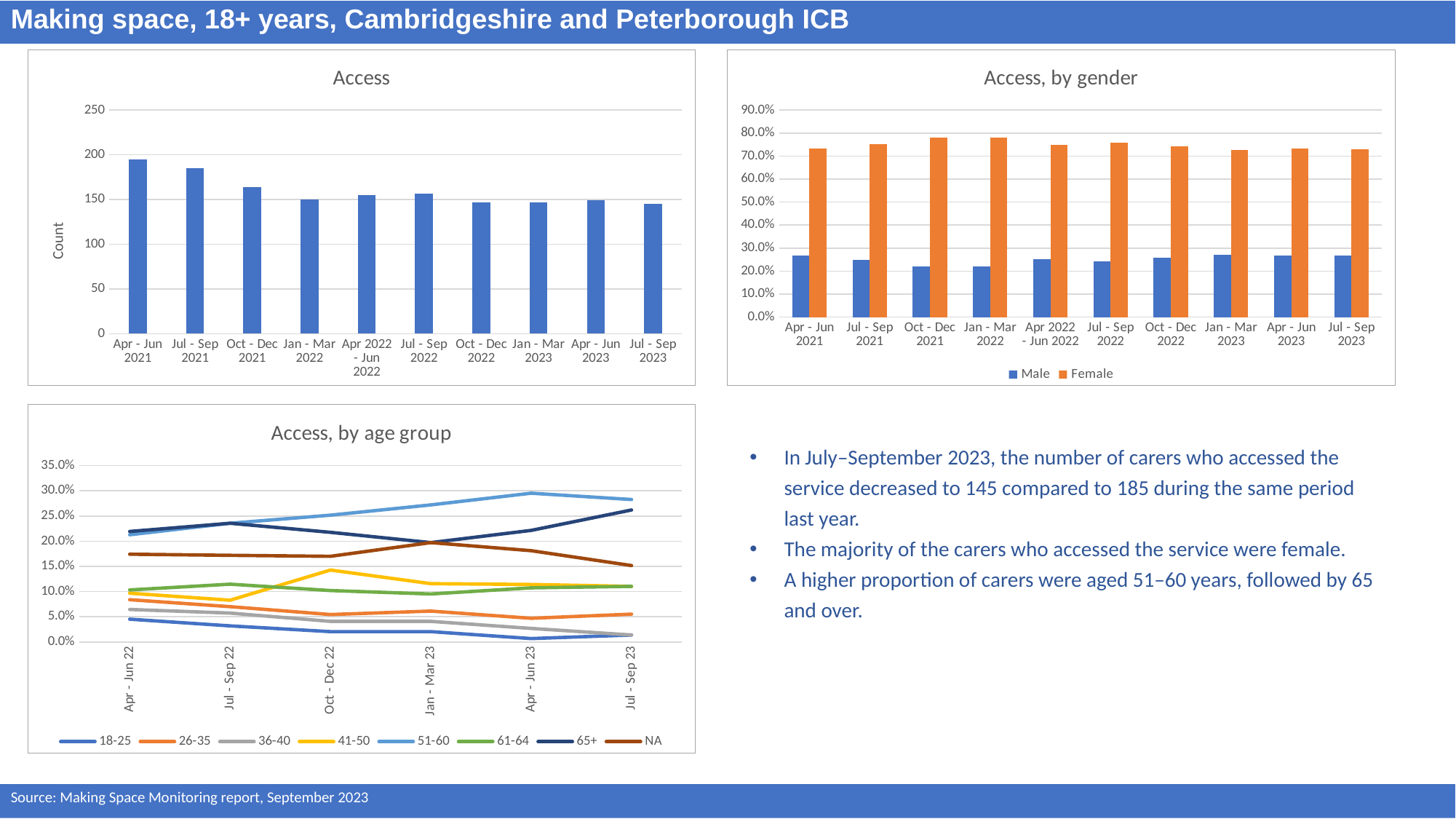
In the "Access" chart, is the count for Jan - Mar 2022 greater or less than 200? less What kind of chart is the "Access" chart? bar chart What kind of chart is the "Access, by age group" chart? line chart How many time periods are shown on the x axis of the "Access" chart? 10 In the "Access" chart, which is larger: the count for Apr - Jun 2021 or the count for Oct - Dec 2021? Apr - Jun 2021 In the "Access, by gender" chart, is the Male value for Oct - Dec 2021 greater or less than 30.0%? less In the "Access" chart, do the counts generally rise or fall from Apr - Jun 2021 to Jul - Sep 2023? fall In the "Access, by gender" chart, which is larger for Apr - Jun 2021: Male or Female? Female In the "Access" chart, which period has the highest count? Apr - Jun 2021 In the "Access" chart, is the count for Apr - Jun 2021 greater or less than 150? greater How many series does the legend of the "Access, by gender" chart list? 2 In the "Access, by age group" chart, which age group has the highest value at Jul - Sep 23? 51-60